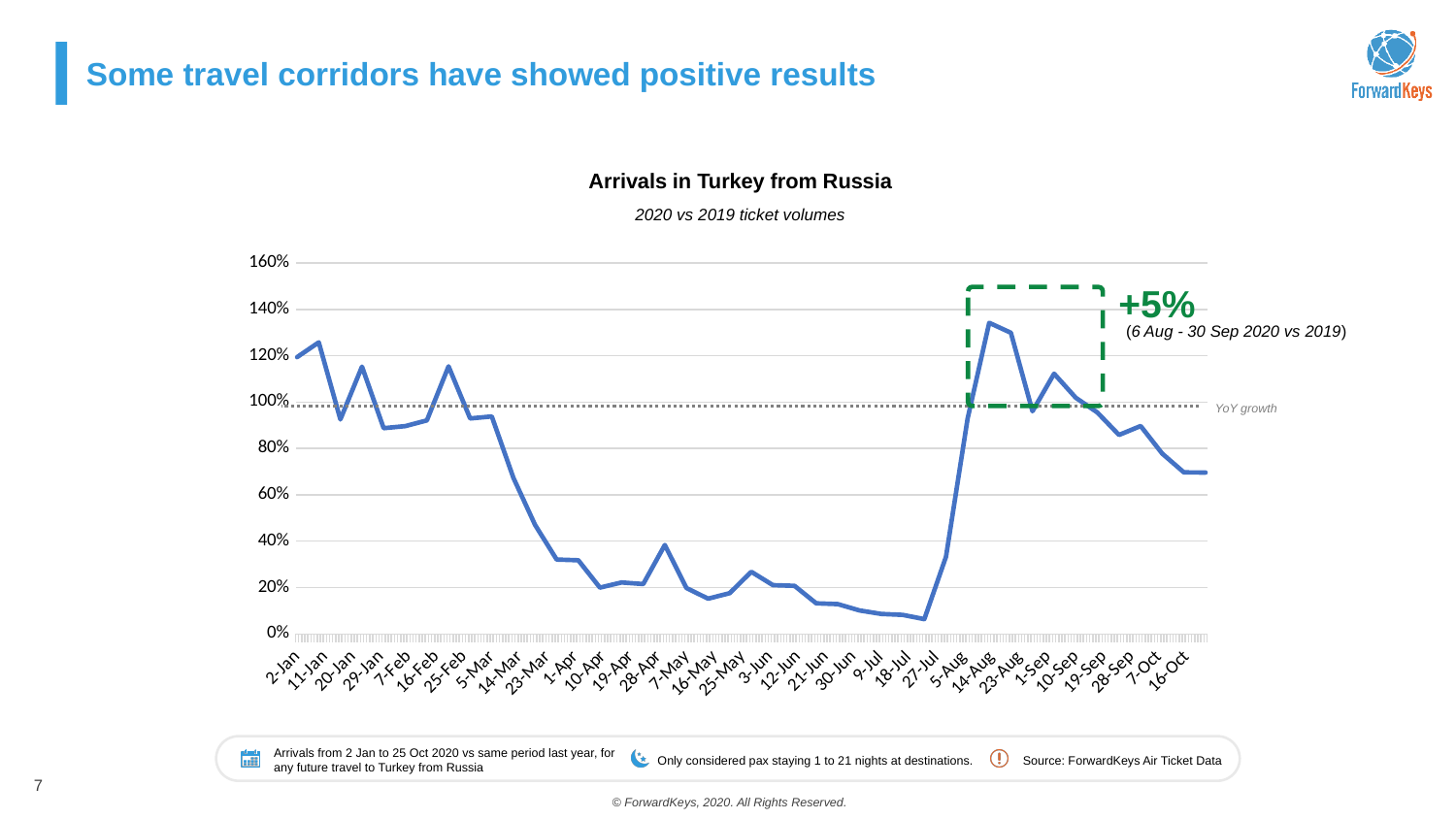
Which is larger, the value for 14-Aug or the value for 18-Jul? 14-Aug Is the value for 16-Oct greater or less than 80%? less What is the title of the chart? Arrivals in Turkey from Russia Is the value for 14-Aug greater or less than 120%? greater Is the value for 11-Jan greater or less than 100%? greater Do the values rise or fall between 27-Jul and 14-Aug? rise What kind of chart is shown on the slide? Line chart Do the values rise or fall between 25-Feb and 23-Mar? fall At what percentage level is the dotted horizontal reference line labelled 'YoY growth' drawn? 100% What growth figure is annotated for the period 6 Aug - 30 Sep 2020 vs 2019? +5%